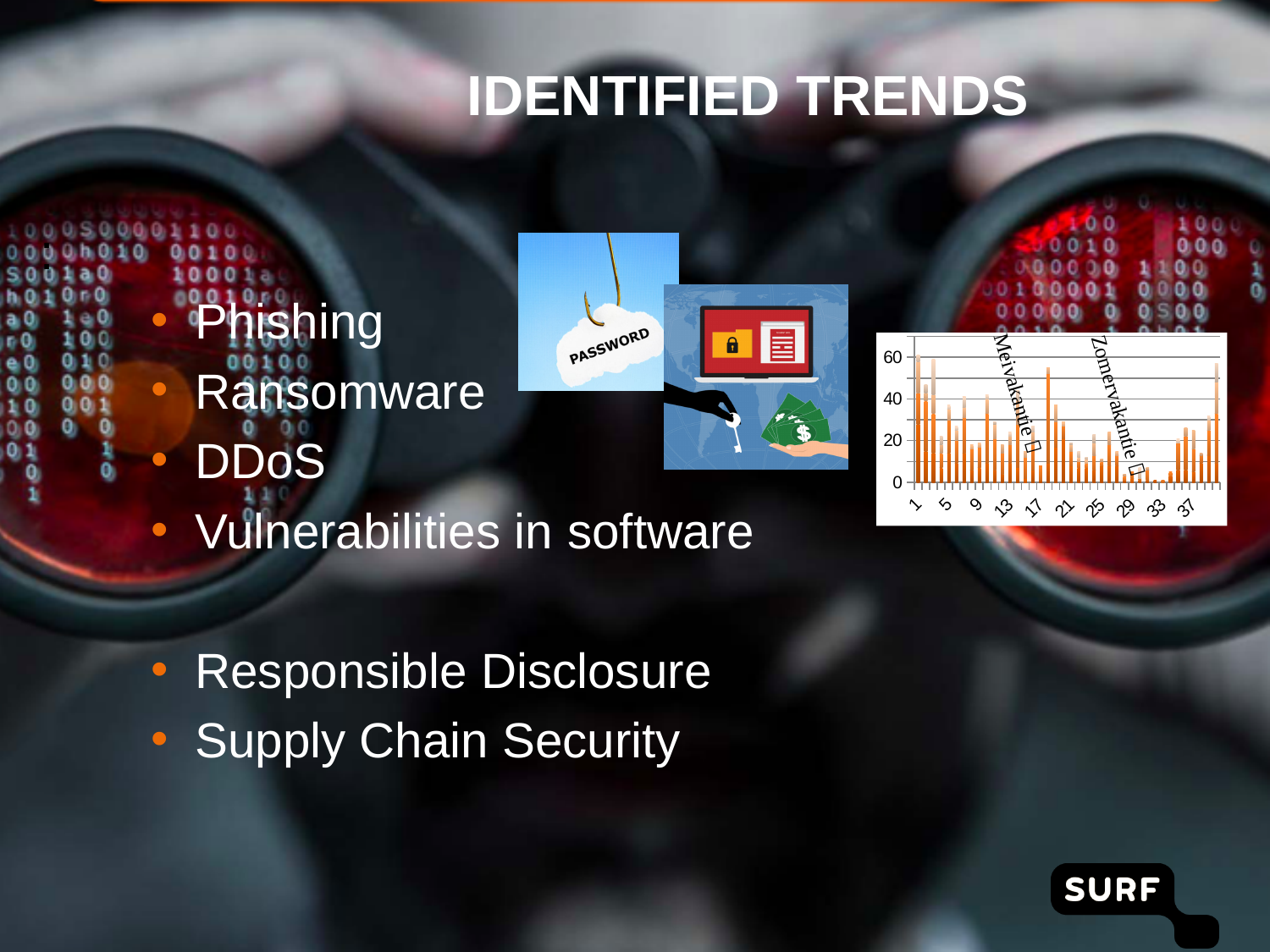
On the bar chart, is the value for category 1 greater or less than 20? greater What is the last tick label shown on the x-axis of the bar chart? 37 What is the highest tick value shown on the y-axis of the bar chart? 60 On the bar chart, is the value for category 1 greater or less than 40? greater What kind of chart is shown on the right side of the slide? bar chart What colour are the bars in the bar chart? orange